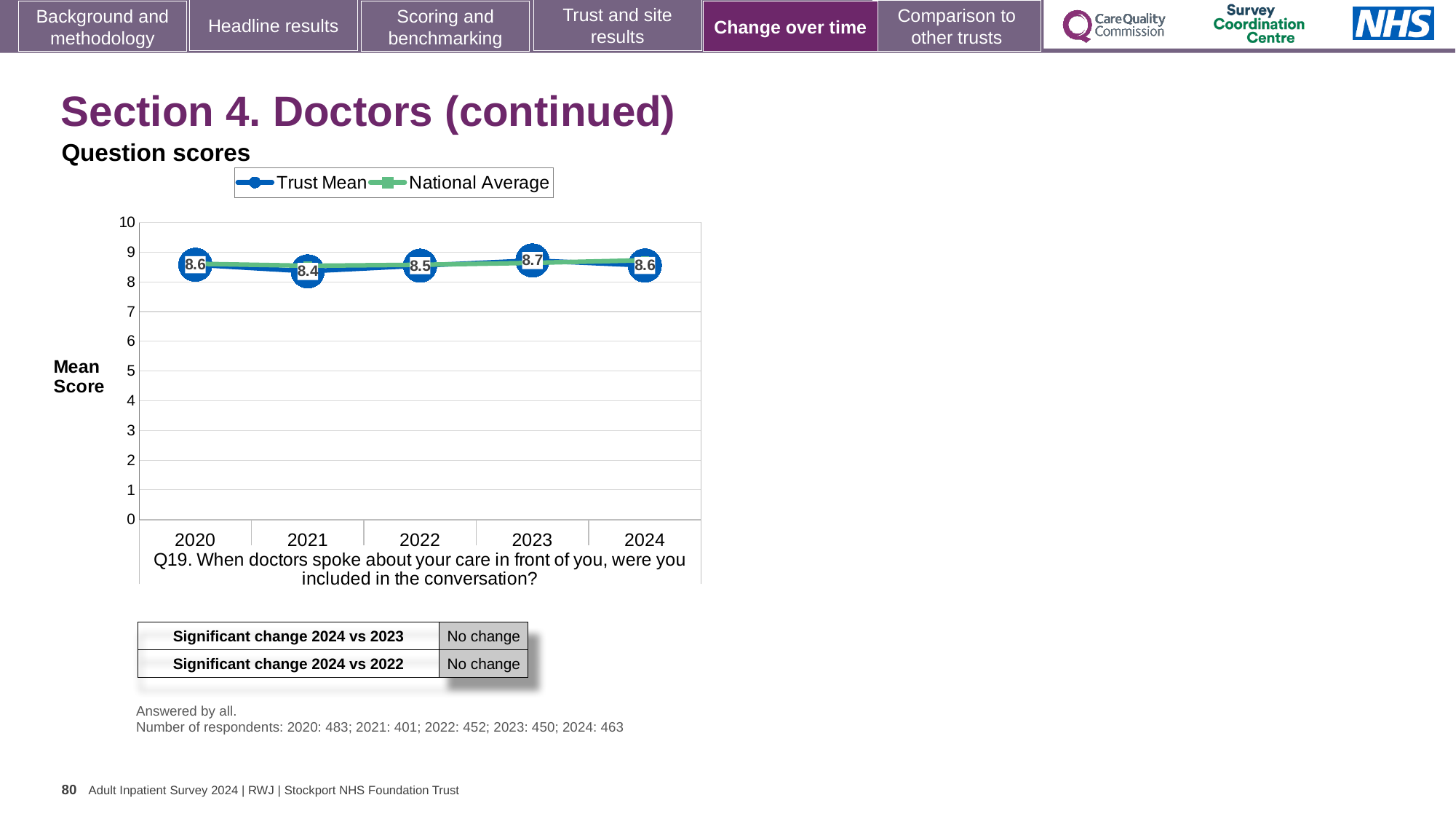
Does the Trust Mean rise or fall from 2021 to 2023? rise What is the Trust Mean value for 2023? 8.7 Is the National Average value for 2020 greater or less than 8? greater What is the Trust Mean value for 2024? 8.6 In which year is the Trust Mean lowest? 2021 What is the difference between the Trust Mean in 2023 and in 2021? 0.3 In which year is the Trust Mean highest? 2023 How many series does the legend list? 2 Which year has the larger Trust Mean, 2020 or 2021? 2020 What is the Trust Mean value for 2021? 8.4 How many years are plotted on the x axis? 5 What kind of chart is shown on the slide? line chart